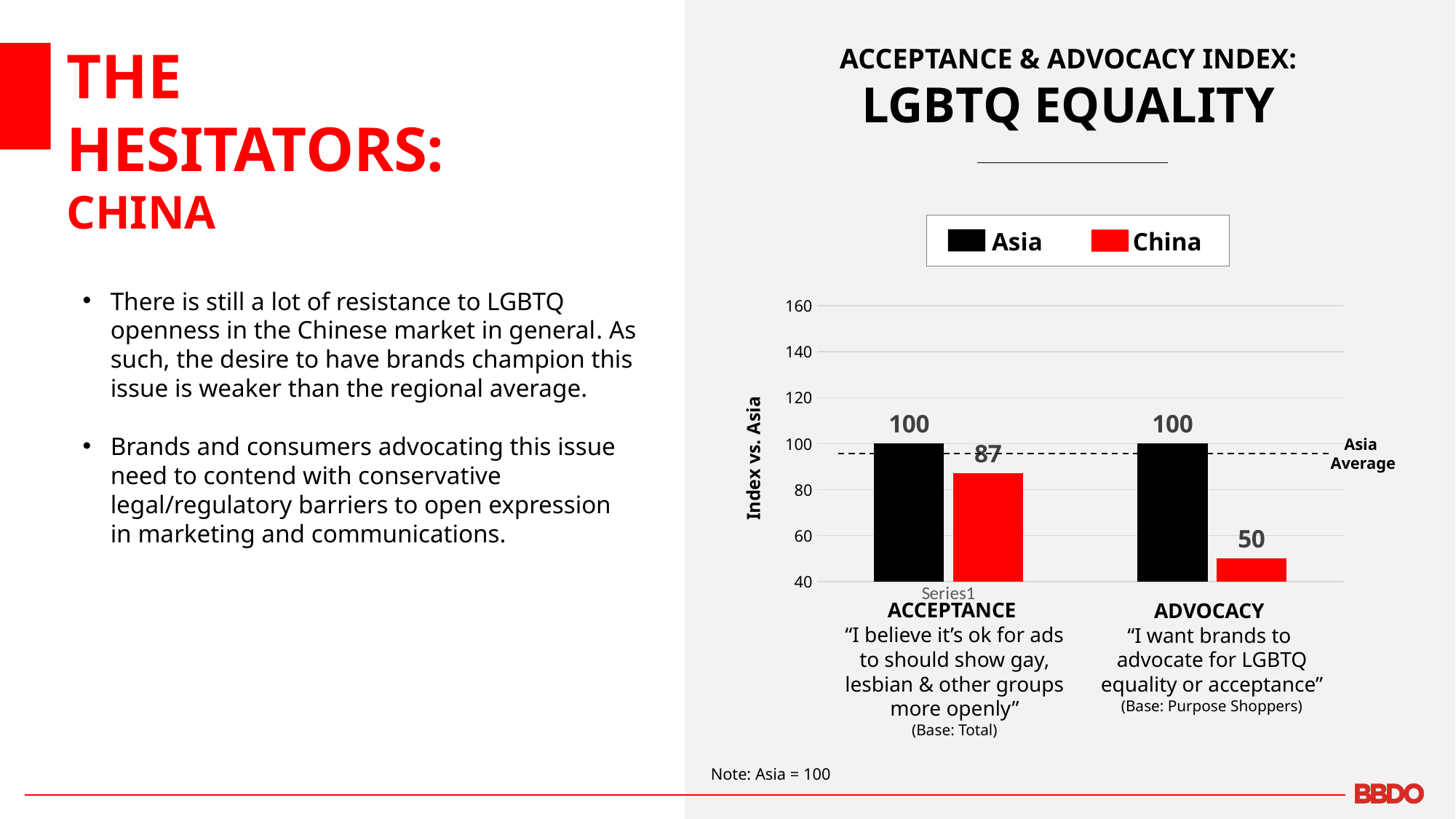
What is the China value for Acceptance? 87 What is the label of the vertical axis? Index vs. Asia Is the China value for Advocacy greater or less than 60? less What colour represents China in the chart? red What kind of chart is shown on the slide? bar chart Is the China value for Acceptance larger or smaller than the Asia value for Acceptance? smaller How many series does the legend list? 2 What is the China value for Advocacy? 50 What is the difference between the Asia and China values for Advocacy? 50 What is the Asia value for Advocacy? 100 What is the difference between the Asia and China values for Acceptance? 13 Which category has the lower China value, Acceptance or Advocacy? Advocacy